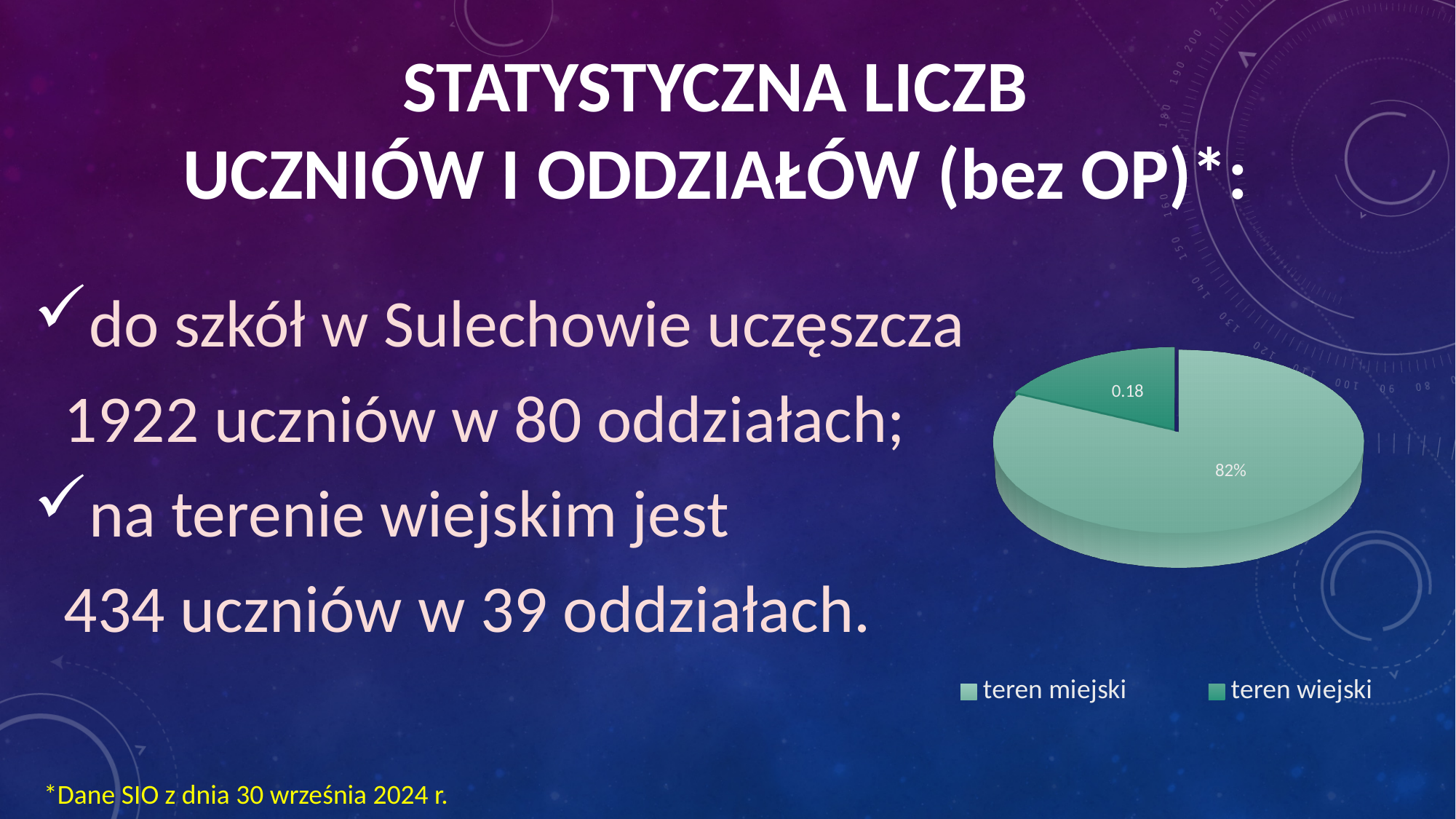
Which is larger in the pie chart, 'teren miejski' or 'teren wiejski'? teren miejski How many slices does the pie chart have? 2 What share of the pie does the 'teren miejski' slice represent, as labelled? 82% Which slice of the pie chart is the smallest? teren wiejski What kind of chart is shown on the slide? pie chart Which legend entry is shown in the darker green colour in the pie chart? teren wiejski What value is printed on the 'teren miejski' slice of the pie chart? 82% What value is printed on the 'teren wiejski' slice of the pie chart? 0.18 Which slice of the pie chart is the largest? teren miejski How many entries does the legend of the pie chart list? 2 What are the two legend entries of the pie chart? teren miejski, teren wiejski